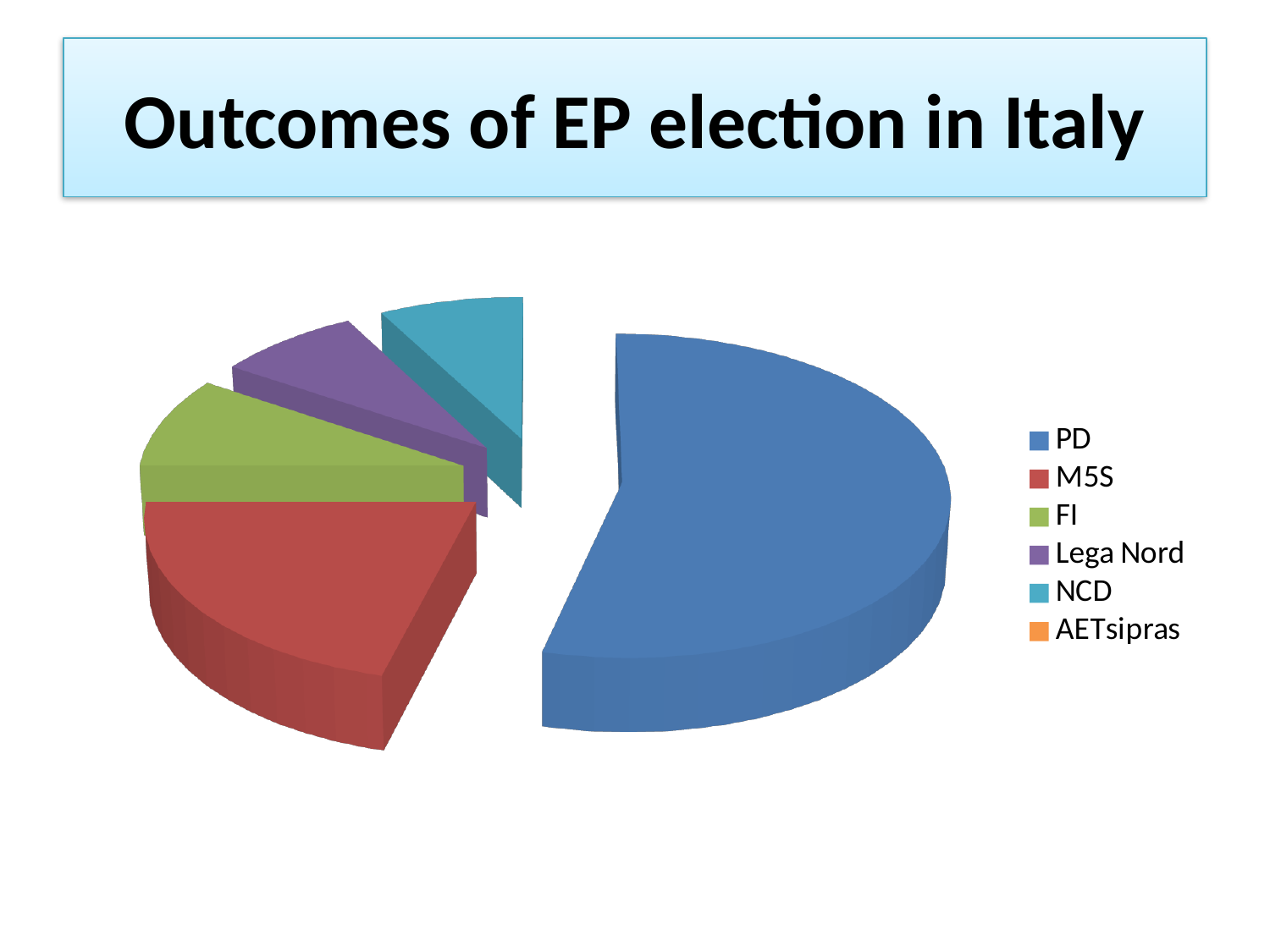
Which slice is larger, PD or M5S? PD Which category is the second largest slice of the pie chart? M5S What is the title of the slide containing the pie chart? Outcomes of EP election in Italy Which category has the largest slice of the pie chart? PD Which slice is larger, FI or NCD? FI Which slice is larger, M5S or Lega Nord? M5S How many categories does the legend of the pie chart list? 6 Which category is shown in blue in the pie chart? PD What kind of chart is shown on the slide? pie chart